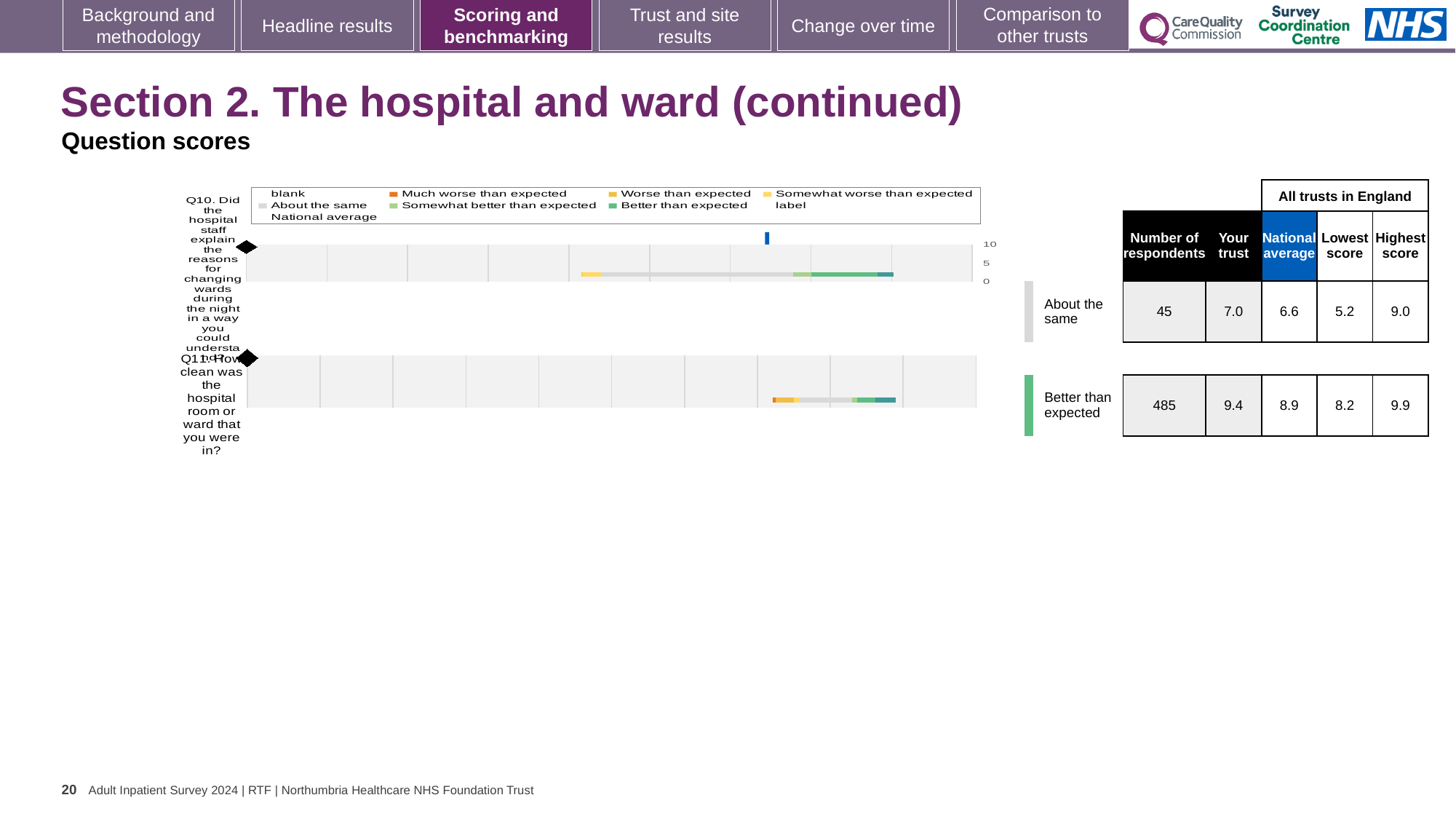
What is the national average score for Q10? 6.6 What kind of chart is used to show the question scores for Q10 and Q11? bar chart What is the national average score for Q11? 8.9 Which benchmark category is Q11 placed in? Better than expected How many respondents answered Q10? 45 Which benchmark category is Q10 placed in? About the same Which question has the higher 'Your trust' score, Q10 or Q11? Q11 By how much does the trust's score for Q11 exceed the national average for Q11? 0.5 How many respondents answered Q11? 485 What is the 'Your trust' score for Q10 (Did the hospital staff explain the reasons for changing wards during the night)? 7.0 What is the 'Your trust' score for Q11 (How clean was the hospital room or ward that you were in?)? 9.4 What is the highest score among all trusts in England for Q11? 9.9